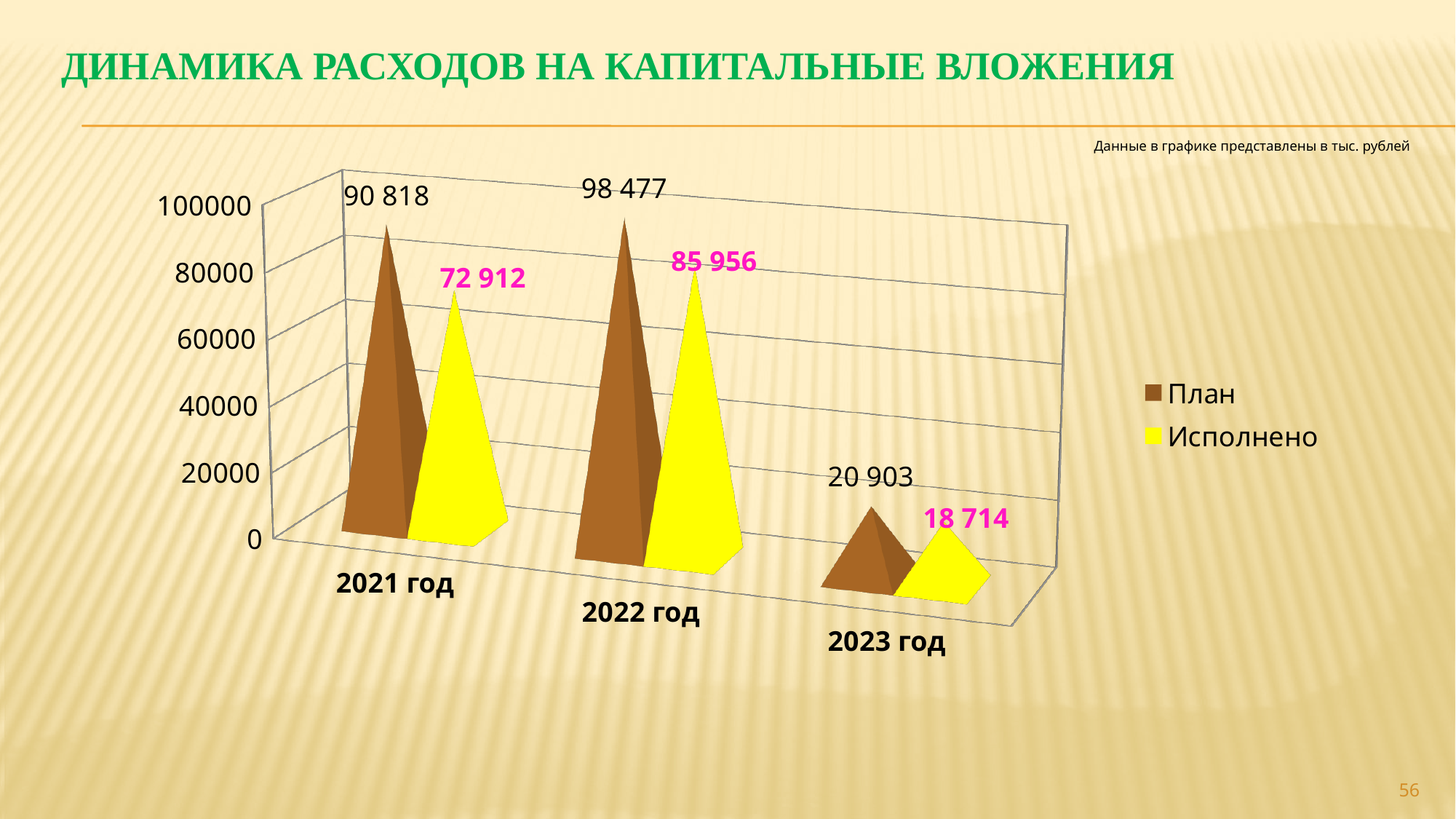
What is the difference between План and Исполнено for 2021 год? 17 906 How many years are shown on the x axis? 3 How many series does the legend list? 2 Is the План value for 2023 год greater or less than 40000? less What is the difference between the План values for 2022 год and 2021 год? 7 659 What kind of chart is shown on the slide? bar chart What is the Исполнено value for 2022 год? 85 956 Which year has the highest План value? 2022 год Which year has the lowest Исполнено value? 2023 год What is the План value for 2021 год? 90 818 What is the Исполнено value for 2023 год? 18 714 Which is larger for 2022 год: План or Исполнено? План